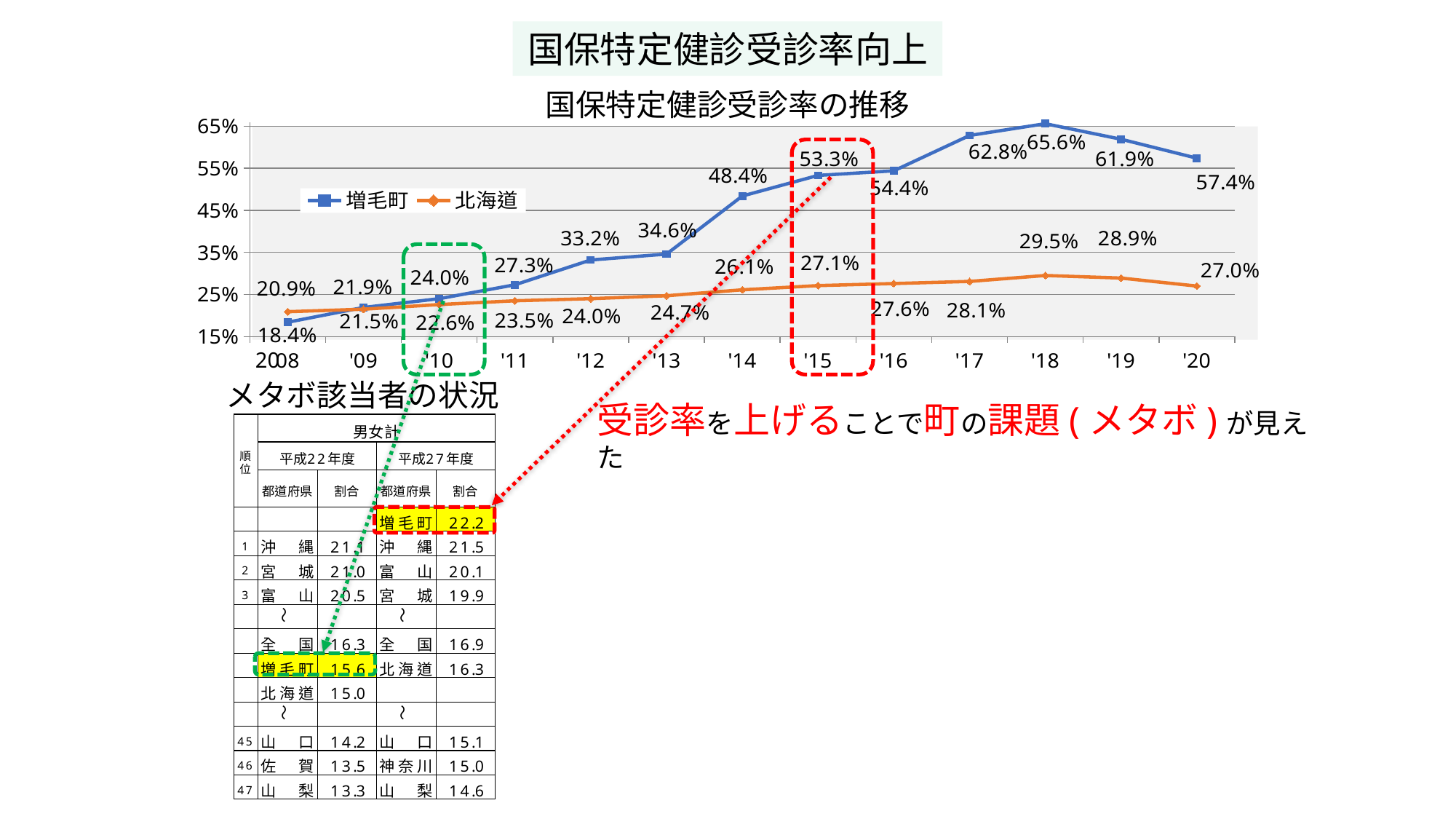
What is the value for 北海道 in '20? 27.0% Which series has the larger value in '17, 増毛町 or 北海道? 増毛町 What is the difference between 増毛町 and 北海道 in '15? 26.2% In which year does the 増毛町 series reach its highest value? '18 How many years are plotted along the x axis of the chart? 13 In which year is the 増毛町 series at its lowest value? 2008 What is the value for 増毛町 in '18? 65.6% How many series does the legend of the chart list? 2 What kind of chart is shown under the title 国保特定健診受診率の推移? line chart What is the value for 北海道 in '15? 27.1% Does the 増毛町 series rise or fall from '18 to '20? fall What is the value for 増毛町 in 2008? 18.4%